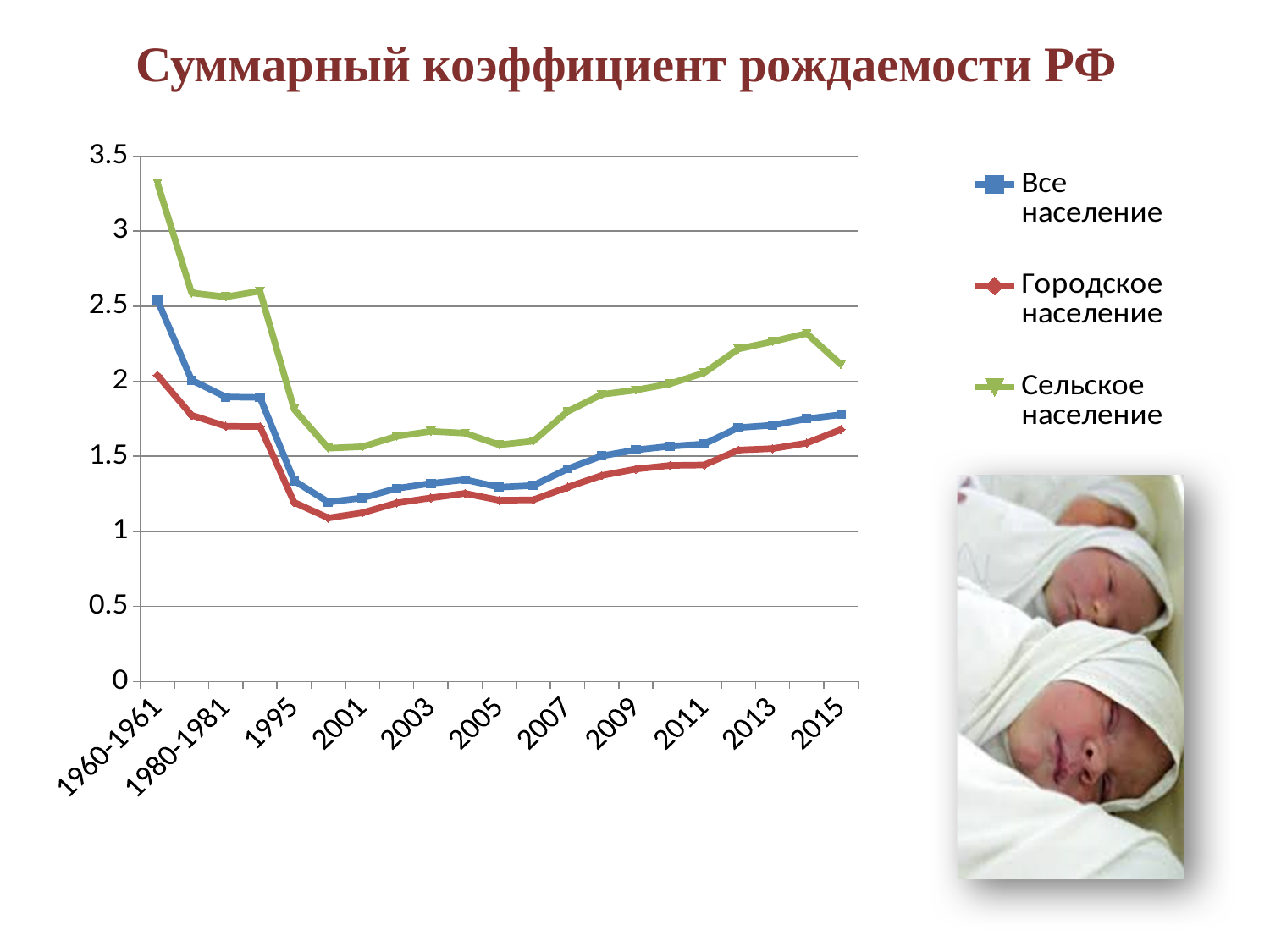
Which is larger at 2015, the value for Сельское население or the value for Городское население? Сельское население Which series has the highest value at 1960-1961? Сельское население How many series does the legend list? 3 Which series has the lowest value at 2001? Городское население What is the title of the chart? Суммарный коэффициент рождаемости РФ Do the values for Все население rise or fall from 2007 to 2015? rise Which series is drawn in green? Сельское население What kind of chart is shown on the slide? line chart Is the value for Городское население at 2001 greater or less than 1.5? less Is the value for Сельское население at 2013 greater or less than 2? greater Is the value for Сельское население at 1960-1961 greater or less than 3? greater